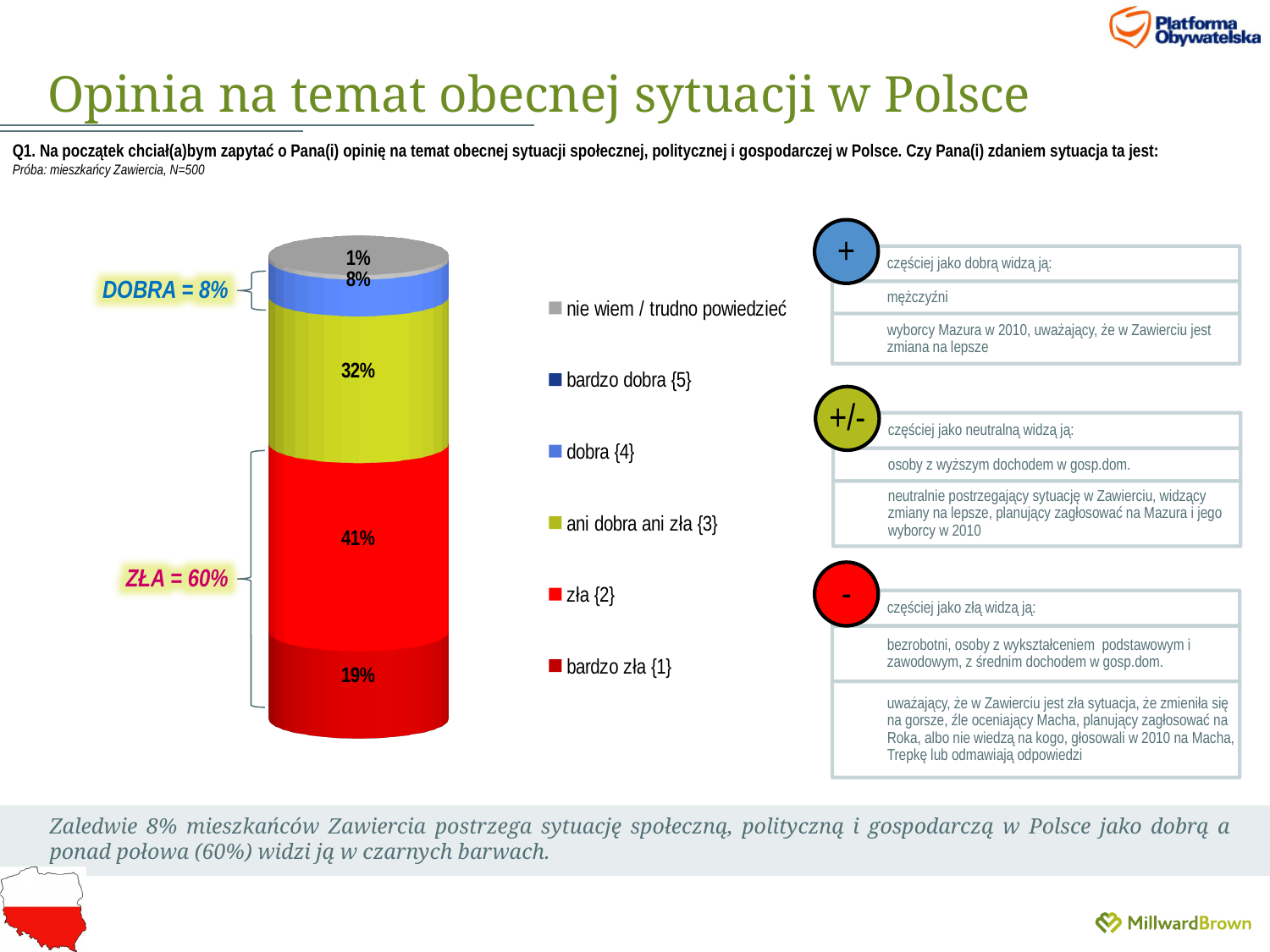
What percentage of respondents answered "ani dobra ani zła {3}"? 32% Which labelled segment of the stacked bar has the smallest share? nie wiem / trudno powiedzieć What type of chart is shown on the slide? Stacked bar chart How many entries does the chart legend list? 6 What percentage of respondents answered "nie wiem / trudno powiedzieć"? 1% What percentage of respondents answered "bardzo zła {1}"? 19% What percentage of respondents answered "zła {2}"? 41% What combined percentage is shown for the "DOBRA" group? 8% Which is larger: the share for "ani dobra ani zła {3}" or the share for "bardzo zła {1}"? ani dobra ani zła {3} What combined percentage is shown for the "ZŁA" group? 60% Which response category has the largest share in the stacked bar? zła {2} What is the difference between the "zła {2}" share and the "bardzo zła {1}" share? 22 percentage points